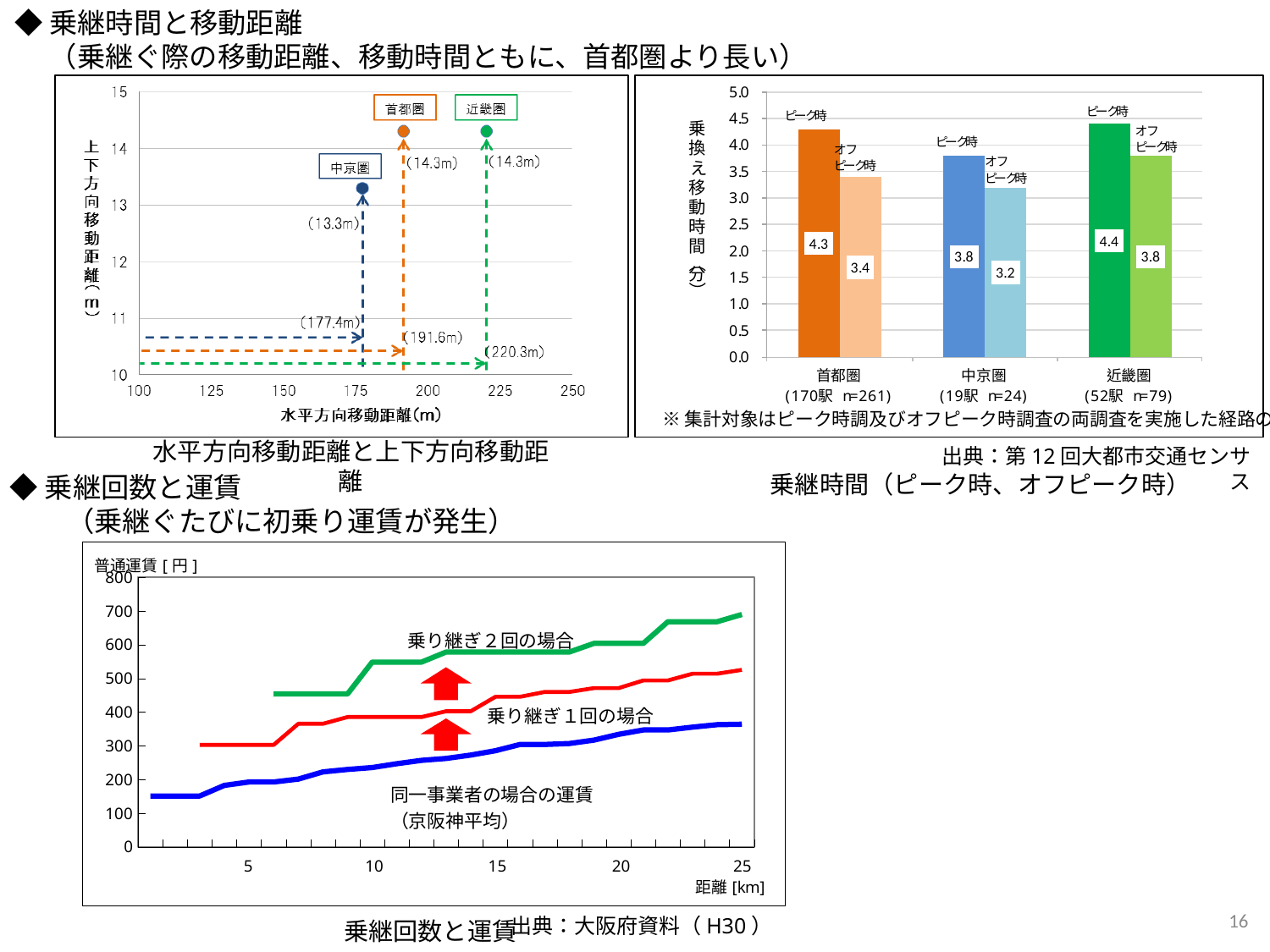
In the top-right bar chart (乗継時間), what is the peak-time (ピーク時) transfer movement time for 首都圏? 4.3 In the bottom chart (乗継回数と運賃), is the fare for 乗り継ぎ2回の場合 at 25 km greater or less than 600? greater In the bottom chart (乗継回数と運賃), how many fare lines are plotted? 3 In the top-right bar chart (乗継時間), which region has the lowest off-peak (オフピーク時) transfer movement time? 中京圏 In the top-left chart (水平方向移動距離と上下方向移動距離), what is the horizontal movement distance for 近畿圏? 220.3m In the top-right bar chart (乗継時間), how many regions are shown on the x axis? 3 In the top-right bar chart (乗継時間), what is the difference between the peak-time and off-peak values for 近畿圏? 0.6 In the top-right bar chart (乗継時間), which region has the highest peak-time (ピーク時) transfer movement time? 近畿圏 In the top-right bar chart (乗継時間), what is the off-peak (オフピーク時) transfer movement time for 中京圏? 3.2 In the top-left chart (水平方向移動距離と上下方向移動距離), what is the vertical movement distance for 中京圏? 13.3m In the top-left chart (水平方向移動距離と上下方向移動距離), which region has the shortest horizontal movement distance? 中京圏 What kind of chart is the top-right chart (乗継時間)? bar chart